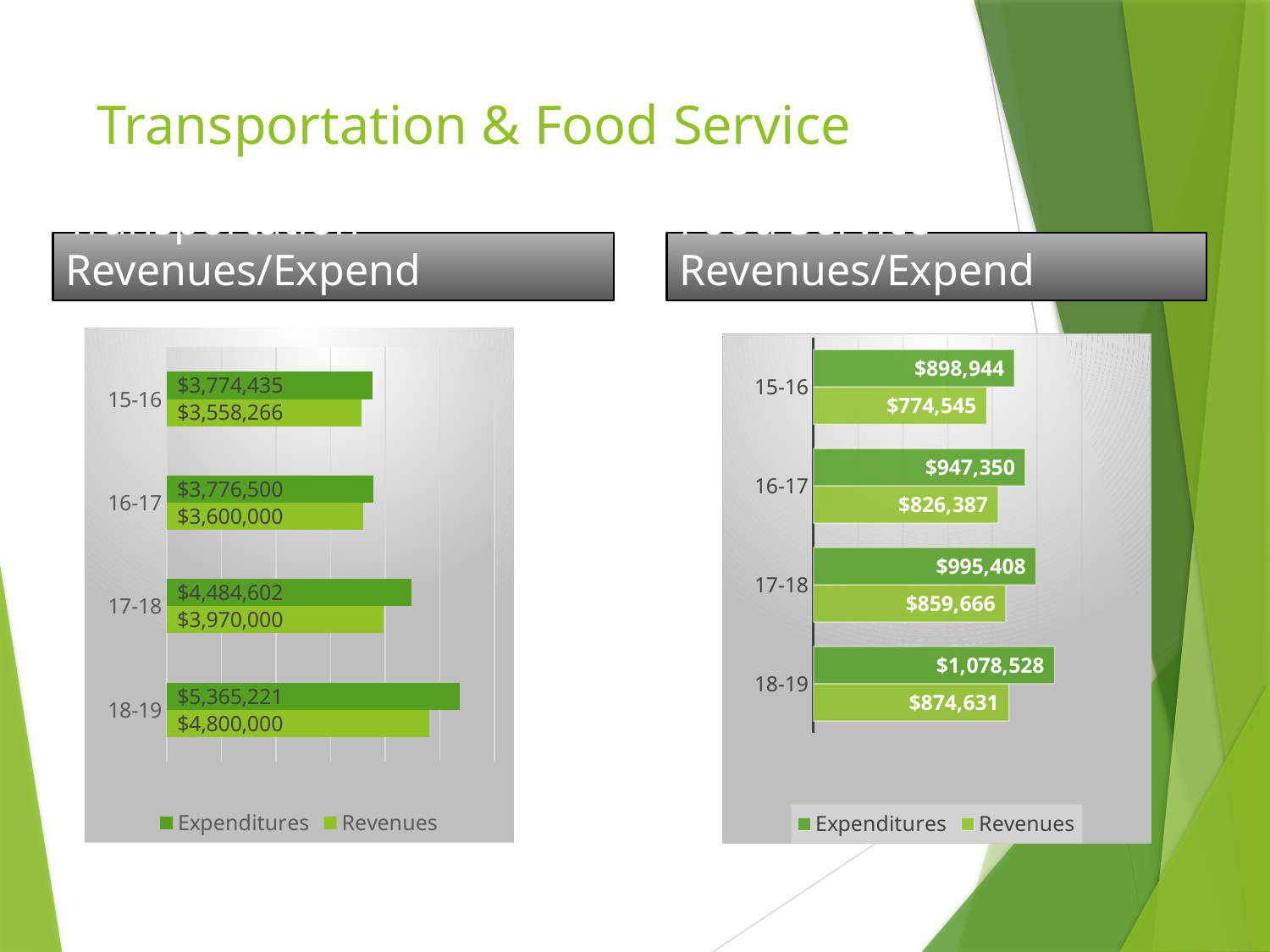
On the right chart, what are the Expenditures for 17-18? $995,408 On the right chart, what are the Revenues for 15-16? $774,545 On the right chart, which year has the lowest Revenues? 15-16 On the left chart, what are the Expenditures for 18-19? $5,365,221 On the left chart, what is the difference between Expenditures and Revenues for 18-19? $565,221 What kind of chart is the left chart? Bar chart On the left chart, which year has the highest Expenditures? 18-19 On the right chart, what is the difference between Expenditures and Revenues for 18-19? $203,897 On the left chart, what are the Revenues for 16-17? $3,600,000 How many series does the legend of the right chart list? 2 On the right chart, which is larger for 16-17, Expenditures or Revenues? Expenditures How many years are shown on the left chart? 4